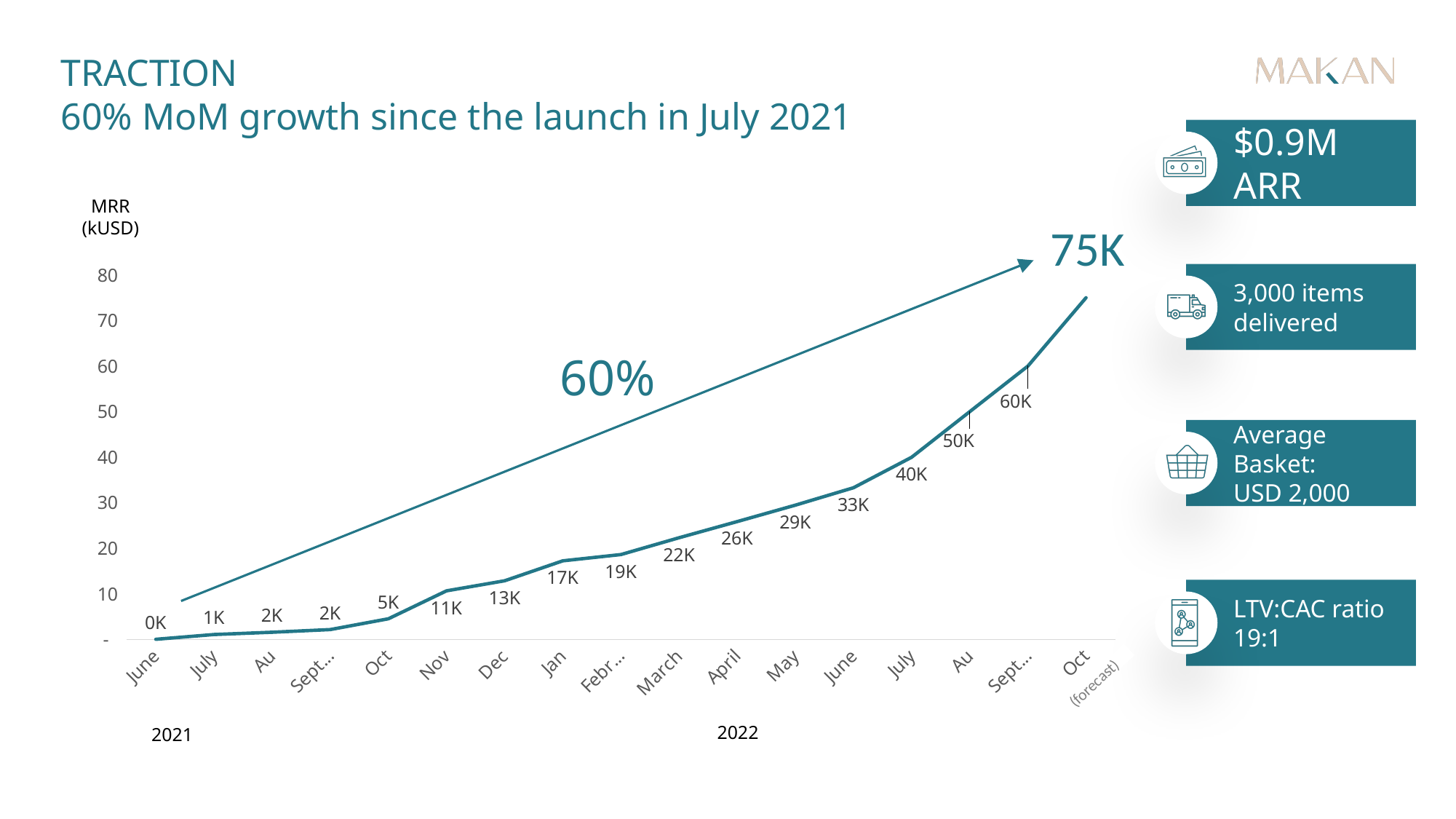
How many data points are plotted on the line? 17 What is the MRR value for March 2022? 22K Which month has the lowest MRR value on the chart? June 2021 What is the MRR value for Nov 2021? 11K What is the MRR value for Oct 2022 (forecast)? 75K What is the difference between the MRR values for July 2022 and June 2022? 7K What is the label of the y axis? MRR (kUSD) What is the MRR value for July 2022? 40K Does the MRR value rise or fall along the x axis from June 2021 to Oct 2022? rise Which is larger, the MRR value for Dec 2021 or the MRR value for Jan 2022? Jan 2022 Is the MRR value for May 2022 greater or less than 20? greater What type of chart is shown on the slide? line chart